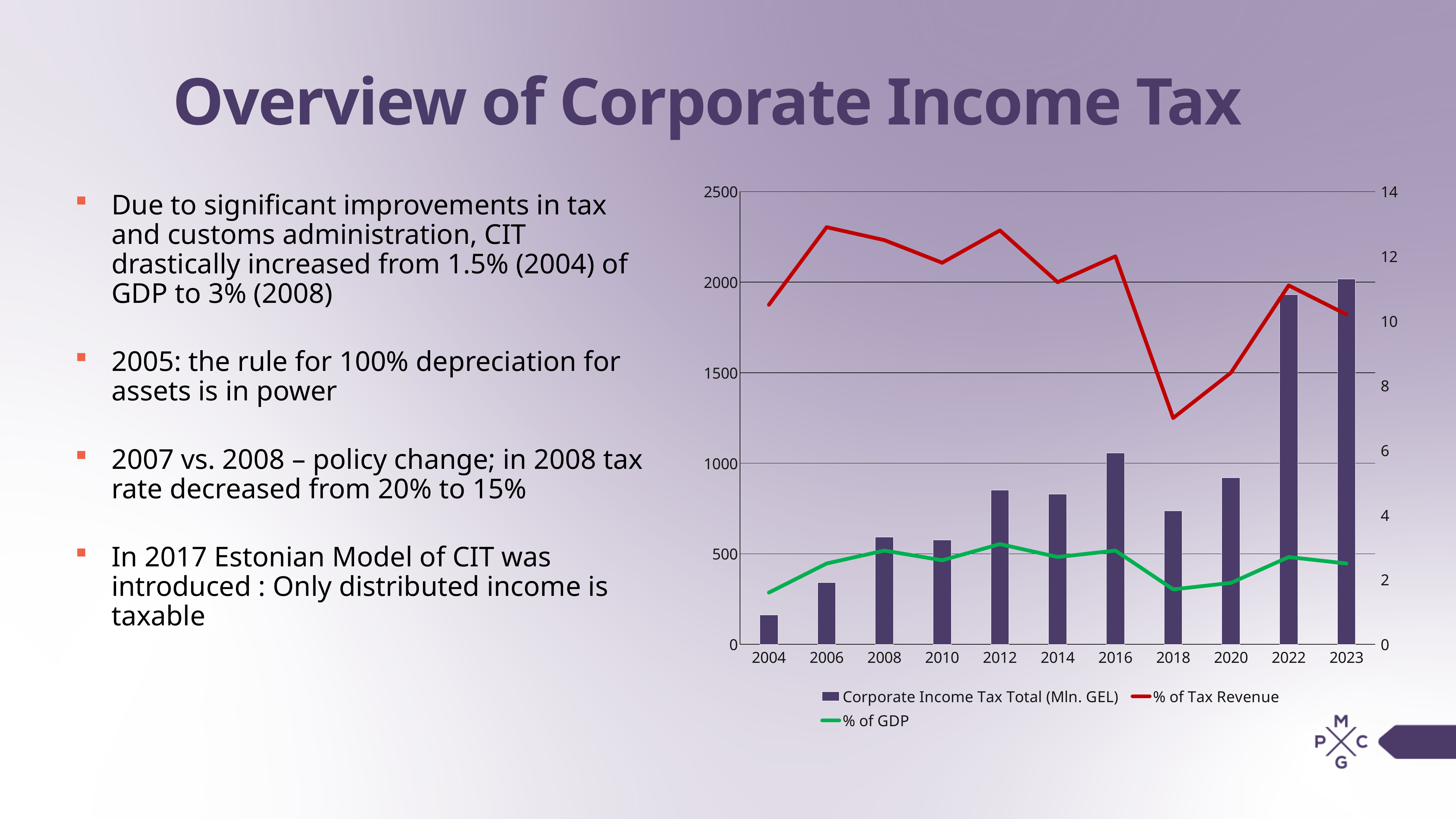
How many series does the chart's legend list? 3 Is the Corporate Income Tax Total bar for 2022 greater or less than 1500? greater Which year has the lowest bar for Corporate Income Tax Total (Mln. GEL)? 2004 How many years are shown on the x axis of the chart? 11 Is the Corporate Income Tax Total bar for 2016 greater or less than 1000? greater Which year has the highest bar for Corporate Income Tax Total (Mln. GEL)? 2023 Which year has the larger Corporate Income Tax Total bar, 2016 or 2018? 2016 Is the Corporate Income Tax Total bar for 2004 greater or less than 500? less What kind of chart is shown on the slide? A combined bar and line chart In which year does the % of Tax Revenue line reach its lowest point? 2018 What colour is the % of GDP line in the chart? Green